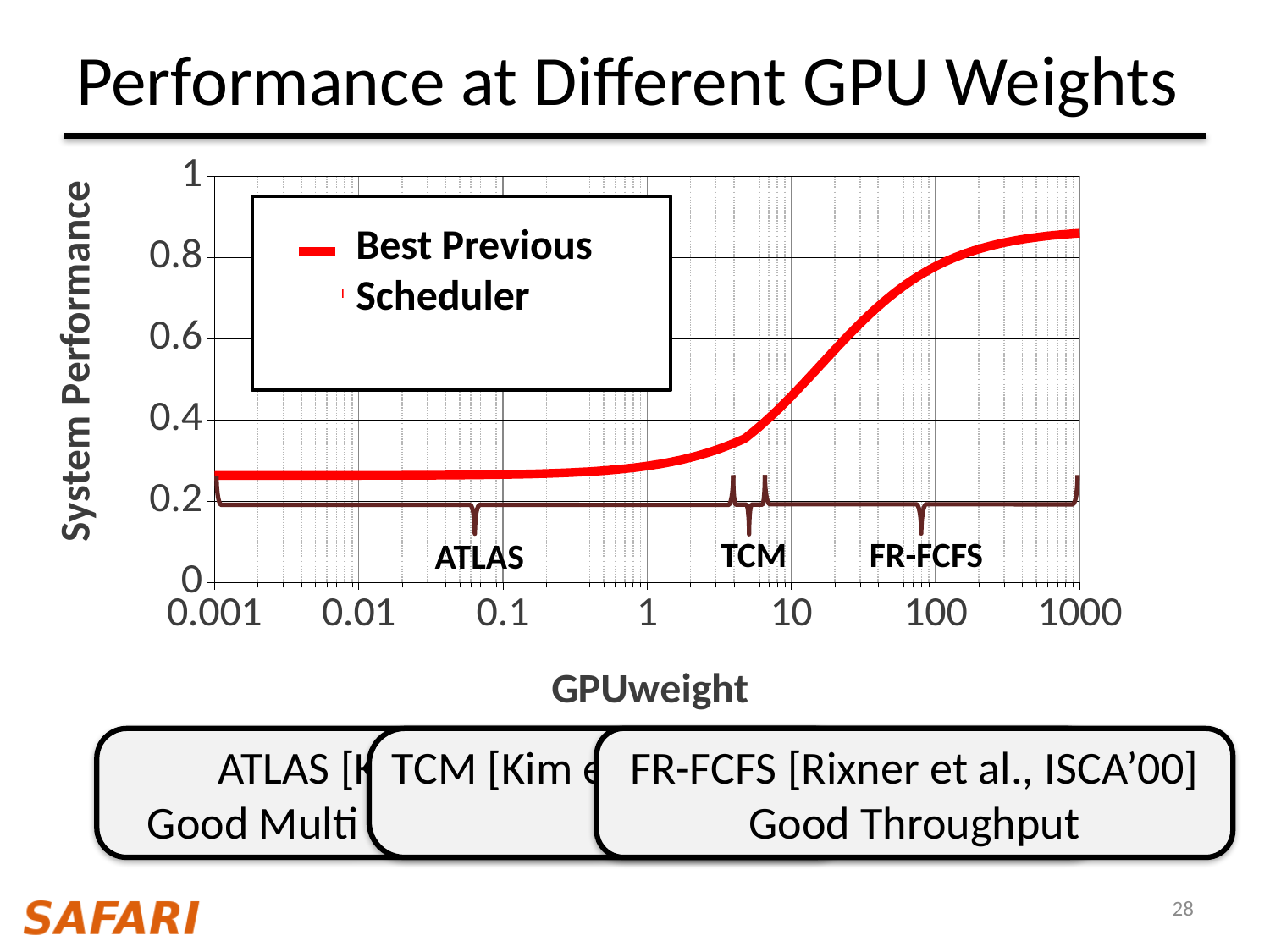
At GPUweight 100, which line is higher: the Best Previous Scheduler line or the thin dark line? Best Previous Scheduler Is the System Performance of the Best Previous Scheduler at GPUweight 1 greater or less than 0.6? less What is the label of the y axis? System Performance For the Best Previous Scheduler, is System Performance higher at GPUweight 1000 or at GPUweight 0.001? 1000 How many labelled tick values are shown on the GPUweight axis? 7 What legend entry is shown for the thick red line? Best Previous Scheduler What is the largest GPUweight value labelled on the x axis? 1000 Is the System Performance of the Best Previous Scheduler at GPUweight 1000 greater or less than 0.8? greater Does the Best Previous Scheduler line rise or fall as GPUweight increases from 0.001 to 1000? rise Is the System Performance of the Best Previous Scheduler at GPUweight 0.001 greater or less than 0.4? less What is the highest value labelled on the System Performance axis? 1 What kind of chart is shown on the slide? line chart